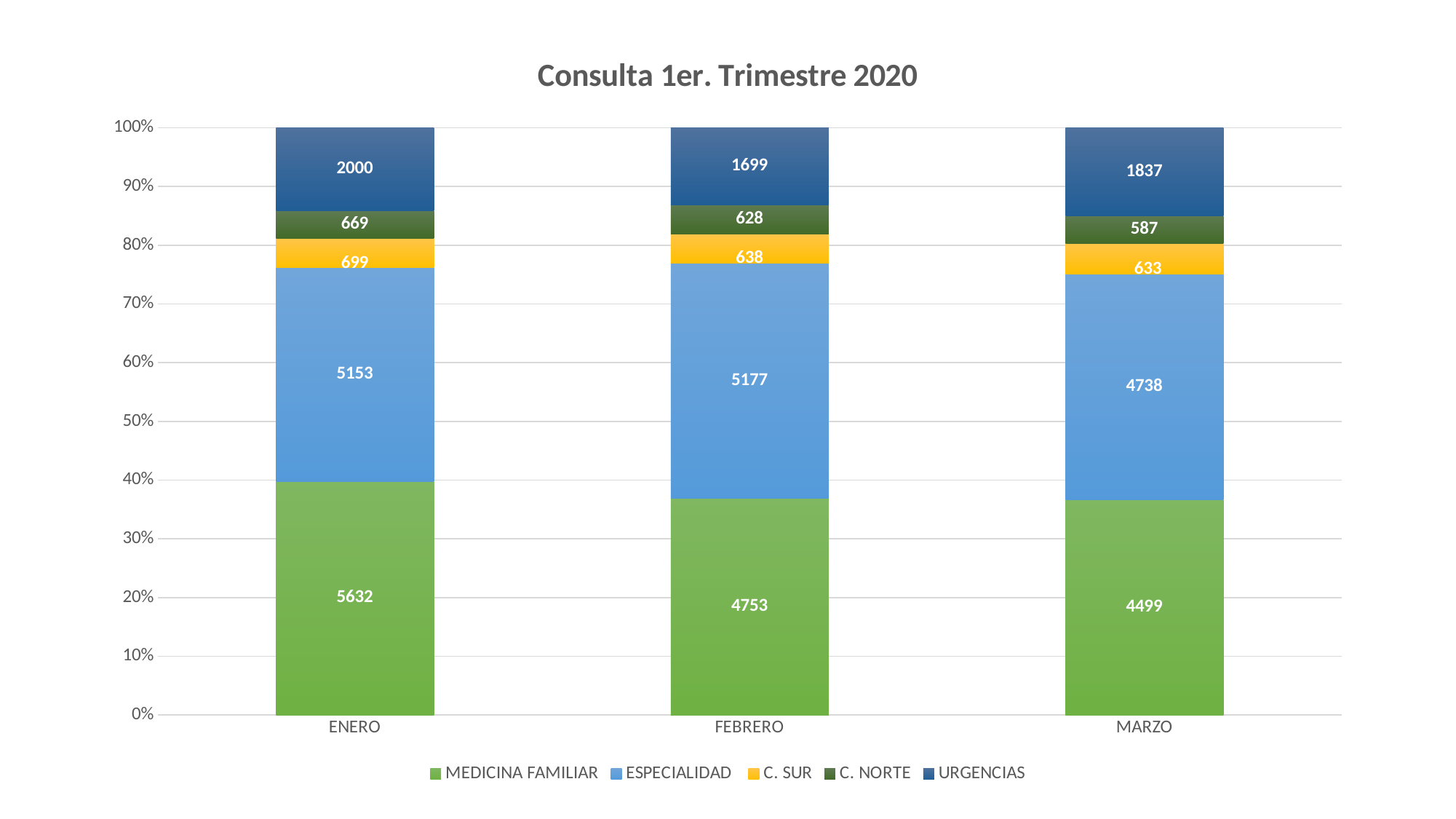
In which month is the URGENCIAS value highest? ENERO In which month is the C. NORTE value lowest? MARZO How many months are shown on the x axis? 3 What is the value for C. SUR in MARZO? 633 What is the total of all series for the MARZO bar? 12294 What is the difference between the MEDICINA FAMILIAR values for ENERO and FEBRERO? 879 What is the value for ESPECIALIDAD in MARZO? 4738 Which is larger in FEBRERO, MEDICINA FAMILIAR or ESPECIALIDAD? ESPECIALIDAD What kind of chart is shown? Stacked bar chart What is the value for MEDICINA FAMILIAR in ENERO? 5632 What is the value for URGENCIAS in FEBRERO? 1699 How many series does the legend list? 5